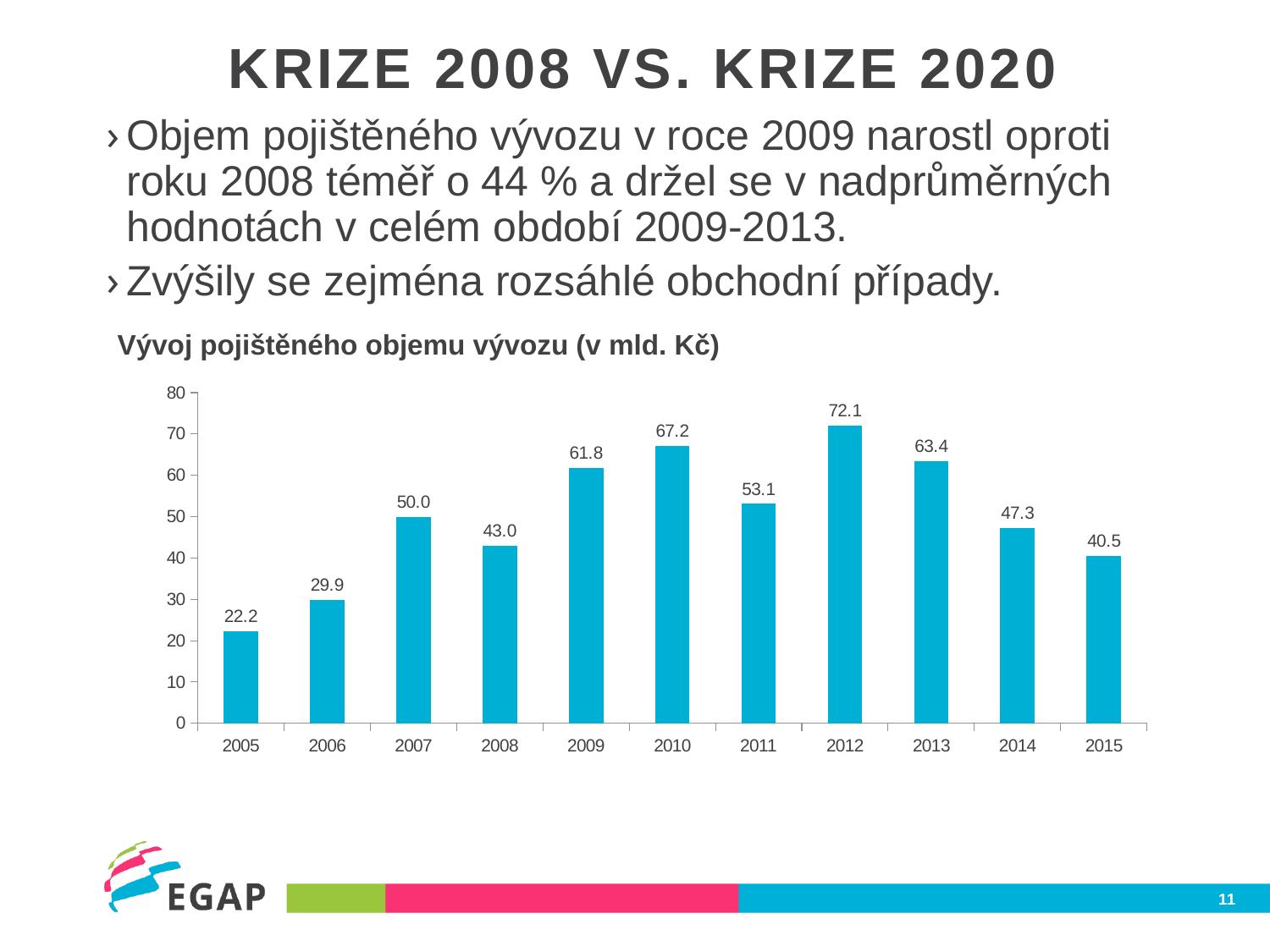
What is the value for 2009 in the chart? 61.8 What is the difference between the values for 2012 and 2013? 8.7 Which year has the lowest value in the chart? 2005 What kind of chart is shown on the slide? bar chart Which is larger, the value for 2011 or the value for 2014? 2011 Which year has the highest value in the chart? 2012 What is the title of the chart? Vývoj pojištěného objemu vývozu (v mld. Kč) Is the value for 2010 greater or less than 60? greater What is the value for 2015 in the chart? 40.5 What is the value for 2005 in the chart? 22.2 How many years are shown on the x axis of the chart? 11 What is the difference between the values for 2009 and 2008? 18.8